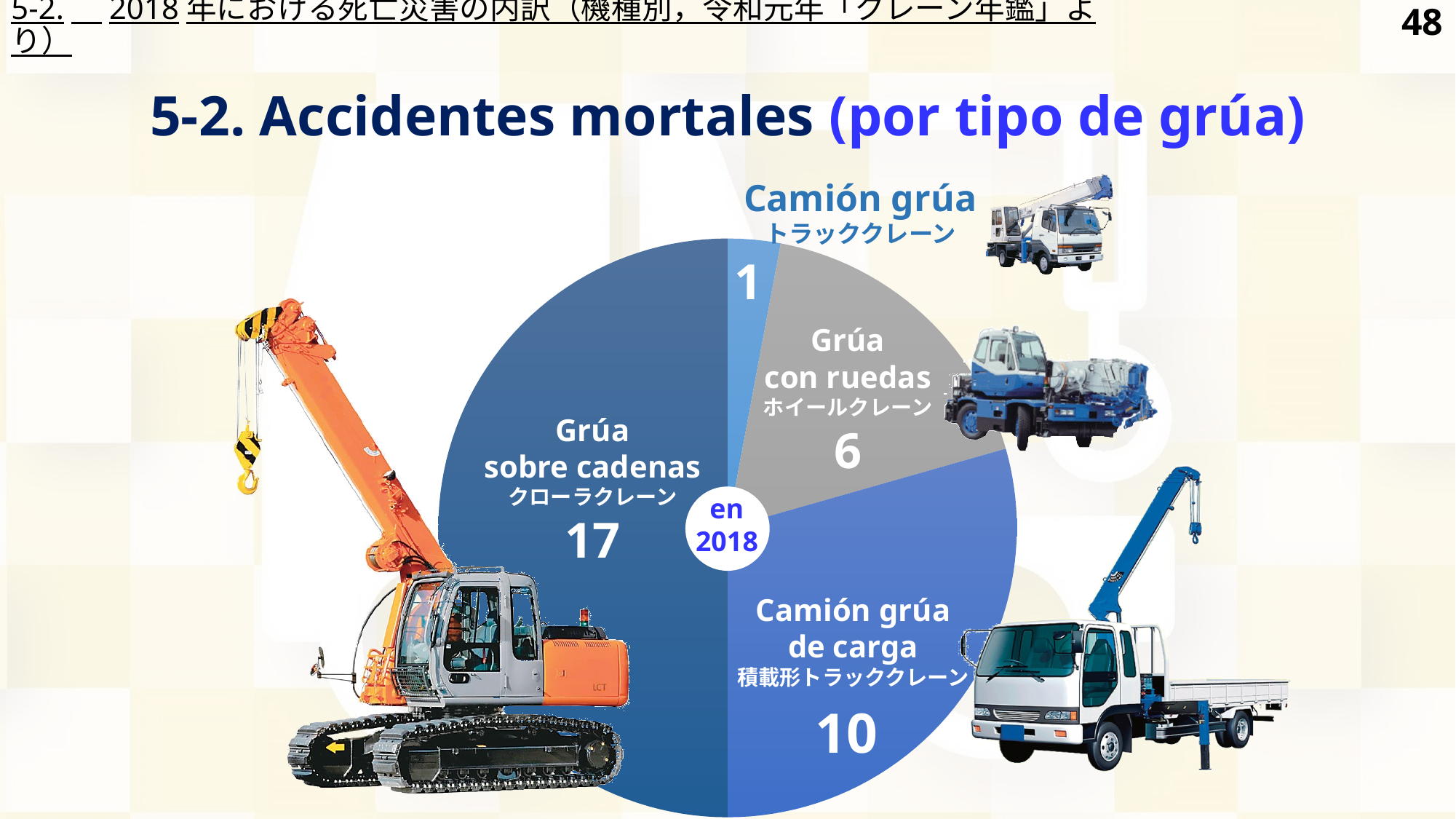
How many slices does the pie chart have? 4 How many fatal accidents are shown for Grúa sobre cadenas? 17 What kind of chart is shown on the slide? pie chart What year is shown in the centre of the pie chart? 2018 What is the value for Grúa con ruedas? 6 What share of the pie does Grúa sobre cadenas represent? 50% What is the value for Camión grúa? 1 Which crane type has the largest slice of the pie? Grúa sobre cadenas Which crane type has the smallest slice of the pie? Camión grúa Which is larger, the value for Grúa con ruedas or the value for Camión grúa de carga? Camión grúa de carga What is the difference between the values for Grúa sobre cadenas and Camión grúa de carga? 7 What is the value for Camión grúa de carga? 10